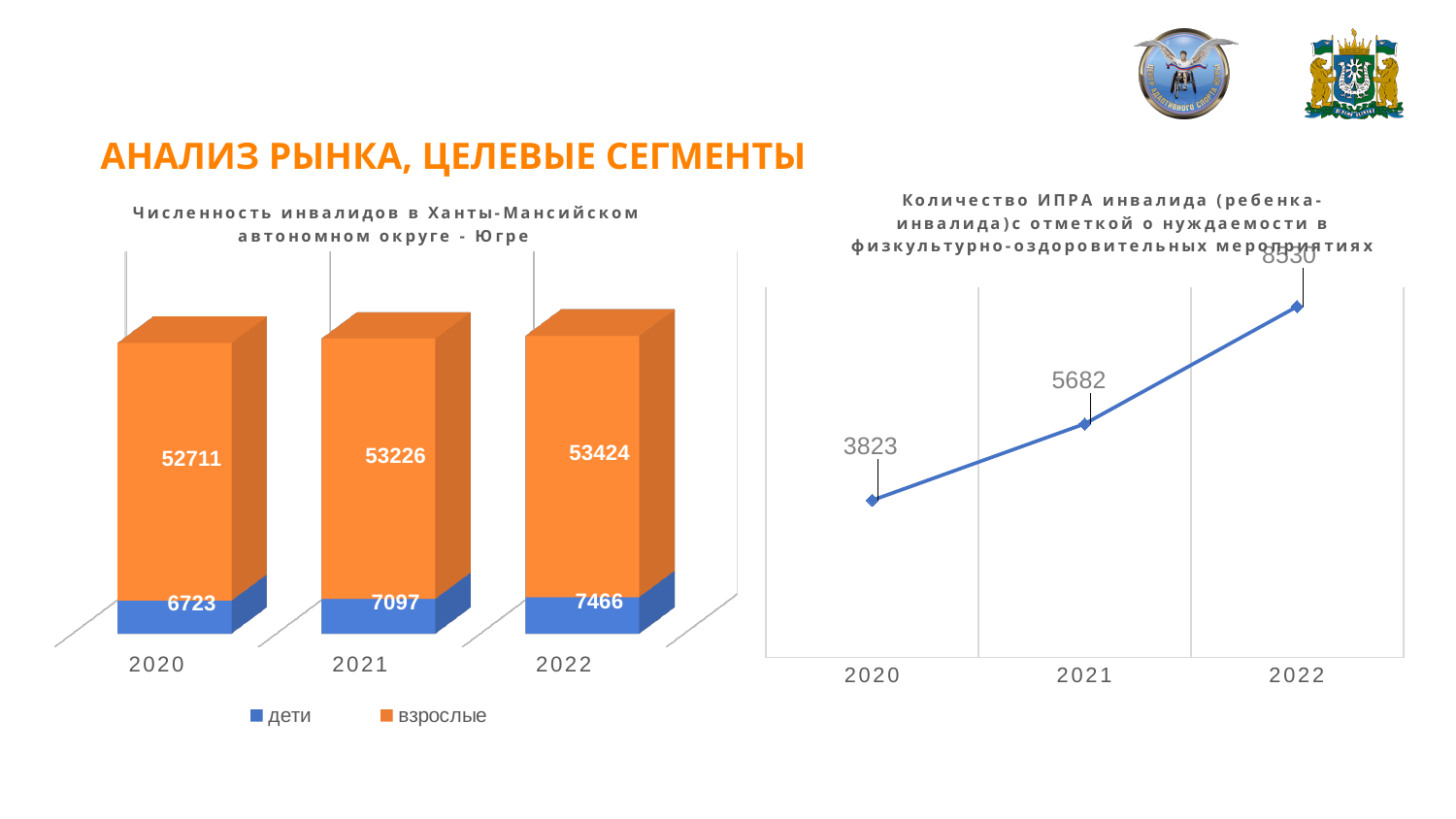
In the right chart (Количество ИПРА инвалида), what is the difference between the values for 2021 and 2020? 1859 In the left chart (Численность инвалидов), which year has the lowest value for дети? 2020 In the left chart (Численность инвалидов), what is the total of the stacked bar for 2021? 60323 In the left chart (Численность инвалидов в Ханты-Мансийском автономном округе - Югре), what is the value for дети in 2020? 6723 In the left chart (Численность инвалидов), what is the value for дети in 2021? 7097 In the right chart (Количество ИПРА инвалида), what is the value for 2021? 5682 In the left chart (Численность инвалидов), which year has the highest value for взрослые? 2022 In the left chart (Численность инвалидов), what is the value for взрослые in 2022? 53424 What kind of chart is the left chart (Численность инвалидов)? Stacked bar chart In the left chart (Численность инвалидов), what is the difference between the дети values for 2022 and 2020? 743 In the left chart (Численность инвалидов), how many series does the legend list? 2 In the right chart (Количество ИПРА инвалида), do the values rise or fall from 2020 to 2022? Rise